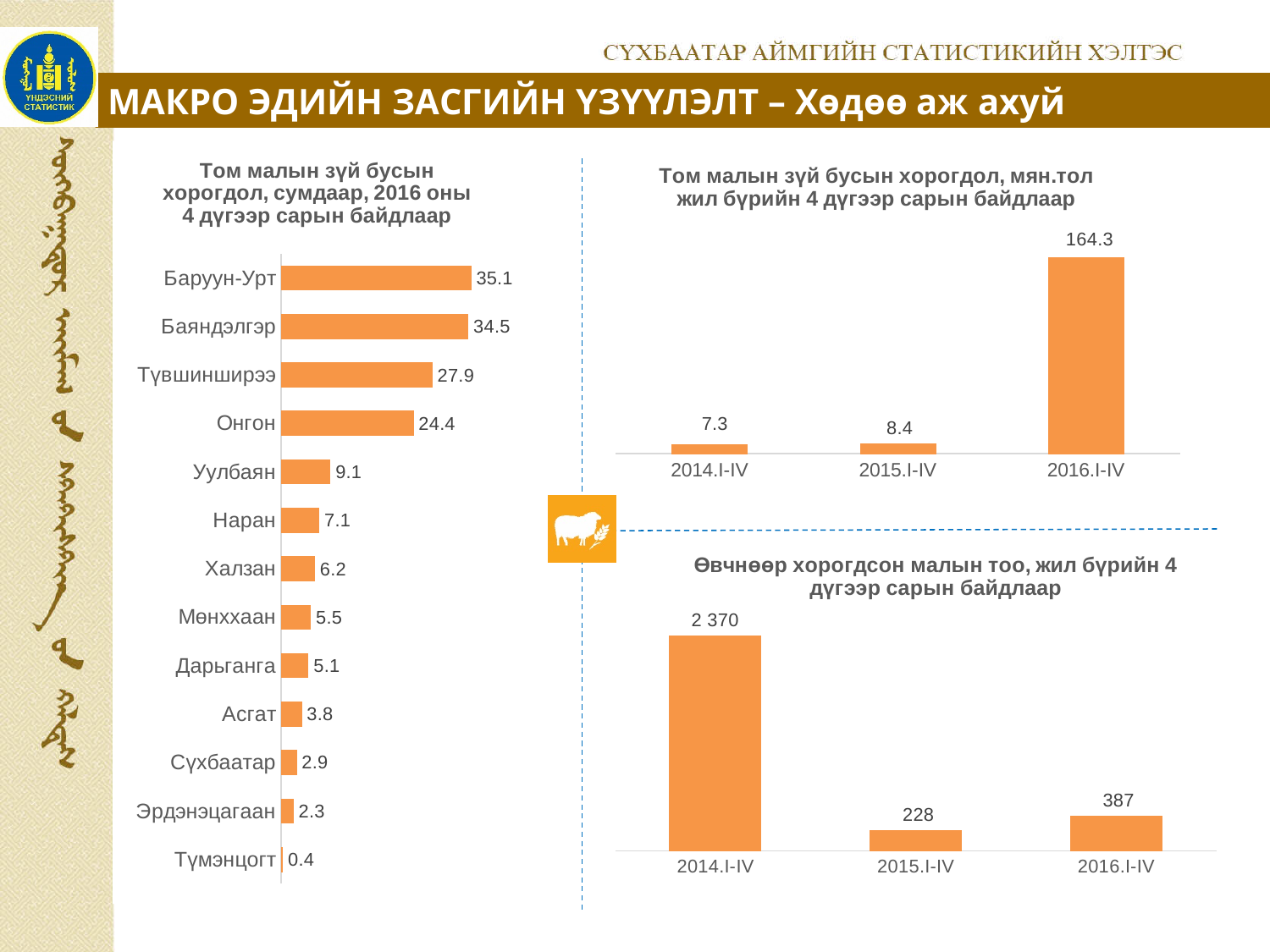
In the left chart (Том малын зүй бусын хорогдол, сумдаар), which category has the lowest value? Түмэнцогт In the left chart (Том малын зүй бусын хорогдол, сумдаар), how many categories are shown? 13 In the left chart (Том малын зүй бусын хорогдол, сумдаар), what is the difference between the values for Түвшинширээ and Онгон? 3.5 In the top-right chart (Том малын зүй бусын хорогдол, мян.тол), what is the value for 2016.I-IV? 164.3 In the bottom-right chart (Өвчнөөр хорогдсон малын тоо), what is the value for 2014.I-IV? 2 370 In the bottom-right chart (Өвчнөөр хорогдсон малын тоо), what is the difference between the values for 2016.I-IV and 2015.I-IV? 159 In the left chart (Том малын зүй бусын хорогдол, сумдаар), which is larger, the value for Уулбаян or the value for Наран? Уулбаян In the top-right chart (Том малын зүй бусын хорогдол, мян.тол), which period has the highest value? 2016.I-IV In the top-right chart (Том малын зүй бусын хорогдол, мян.тол), what is the difference between the values for 2015.I-IV and 2014.I-IV? 1.1 What kind of chart is the left chart (Том малын зүй бусын хорогдол, сумдаар)? Bar chart In the bottom-right chart (Өвчнөөр хорогдсон малын тоо), which period has the lowest value? 2015.I-IV In the left chart (Том малын зүй бусын хорогдол, сумдаар), what is the value for Баруун-Урт? 35.1